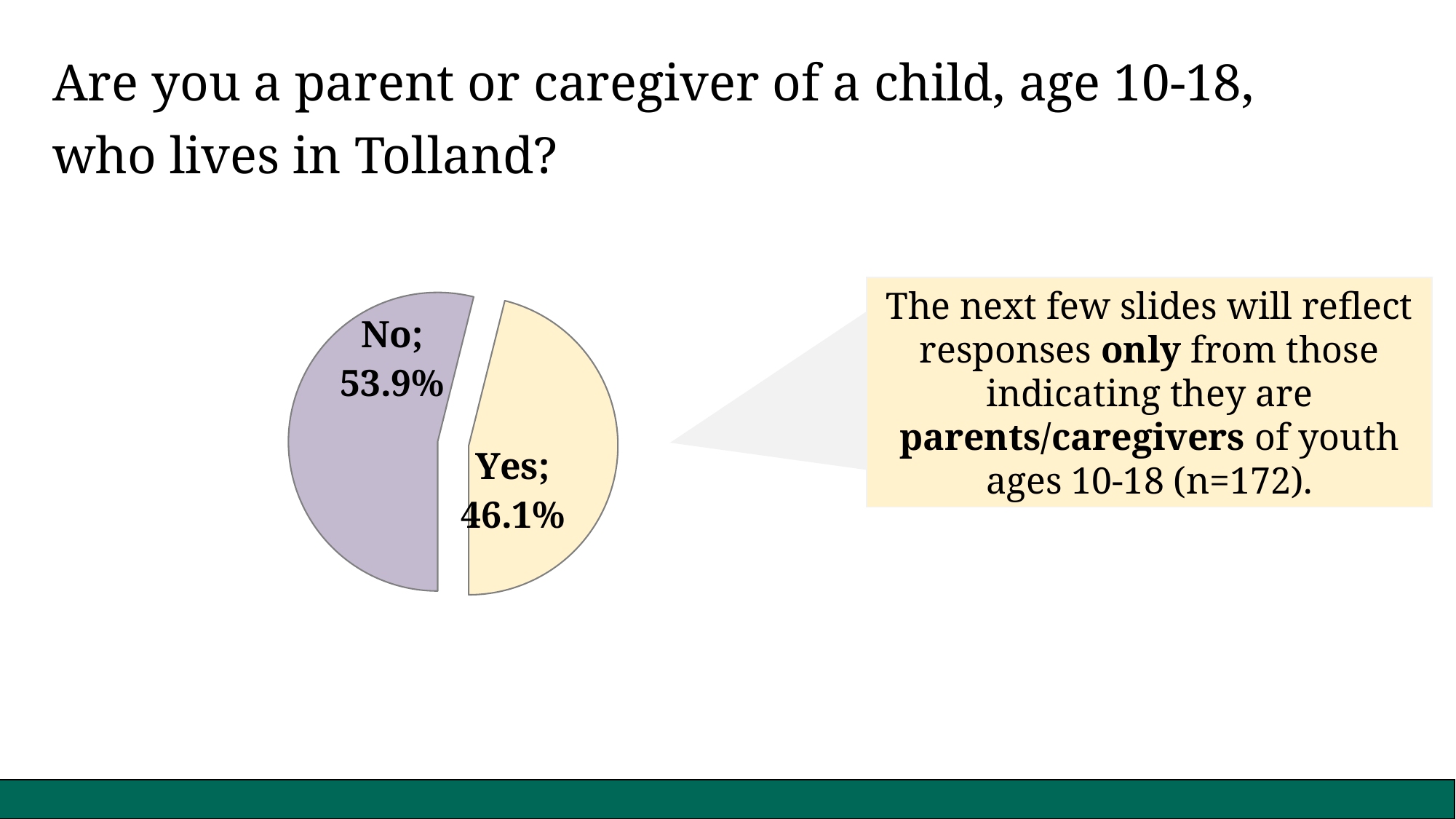
What percentage of respondents answered "Yes"? 46.1% Which response has the smaller share of the pie? Yes How many slices does the pie chart have? 2 What is the difference in percentage points between the "No" and "Yes" slices? 7.8 Is the share for "Yes" larger or smaller than the share for "No"? smaller Which response has the larger share of the pie? No What percentage of respondents answered "No"? 53.9% What colour is the "Yes" slice of the pie chart? light yellow What share of the pie does the "No" slice represent? 53.9% What colour is the "No" slice of the pie chart? light purple What kind of chart is shown on the slide? pie chart